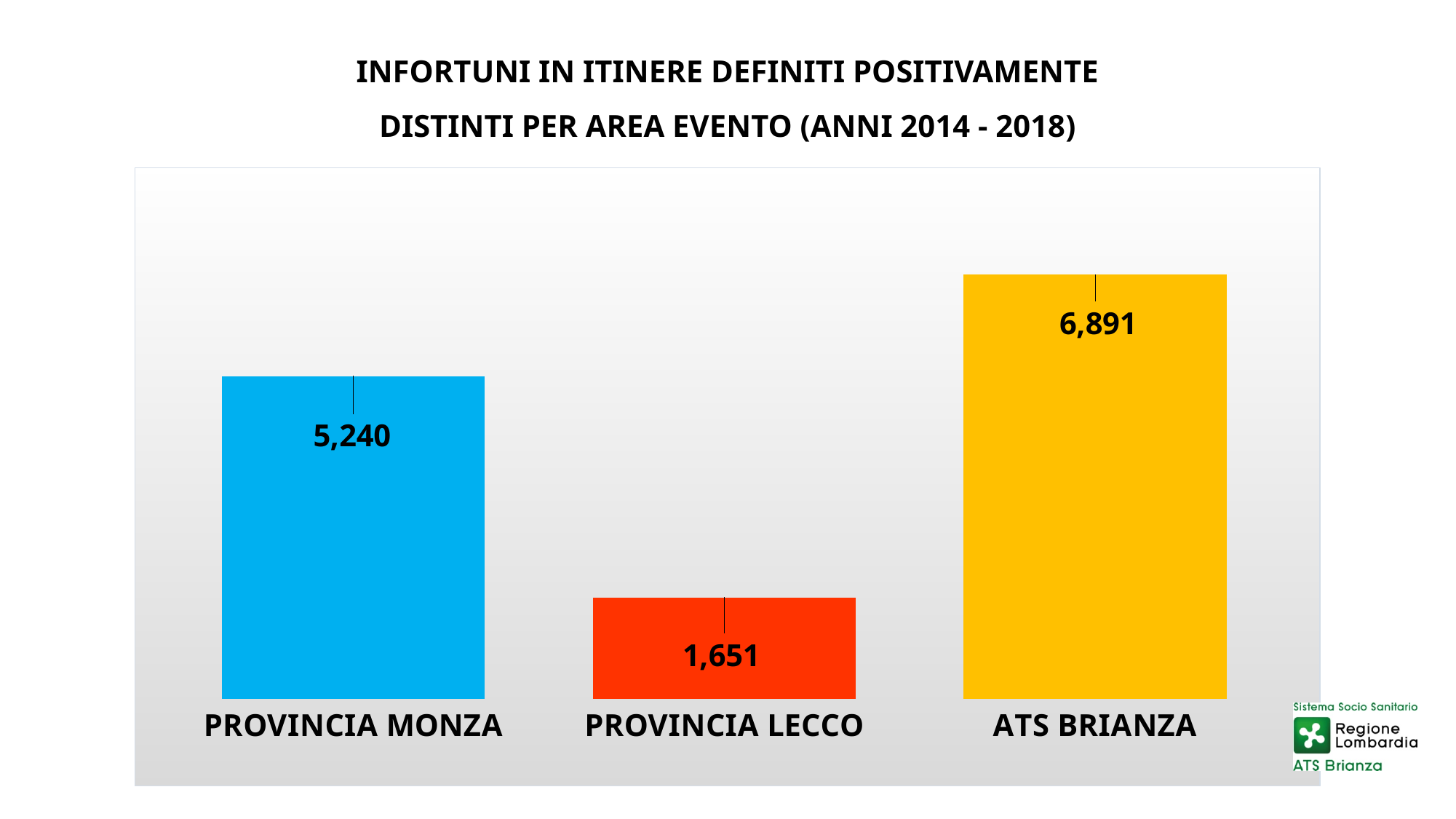
What is the value for ATS BRIANZA? 6,891 Which category has the lowest value? PROVINCIA LECCO What kind of chart is shown on the slide? Bar chart What colour is the bar for ATS BRIANZA? Yellow What is the value for PROVINCIA LECCO? 1,651 Which is larger, the value for PROVINCIA MONZA or the value for PROVINCIA LECCO? PROVINCIA MONZA What is the difference between the values for ATS BRIANZA and PROVINCIA MONZA? 1,651 How many categories are shown in the chart? 3 What is the value for PROVINCIA MONZA? 5,240 Which category has the highest value? ATS BRIANZA What is the difference between the values for PROVINCIA MONZA and PROVINCIA LECCO? 3,589 What period of years does the chart title refer to? 2014 - 2018